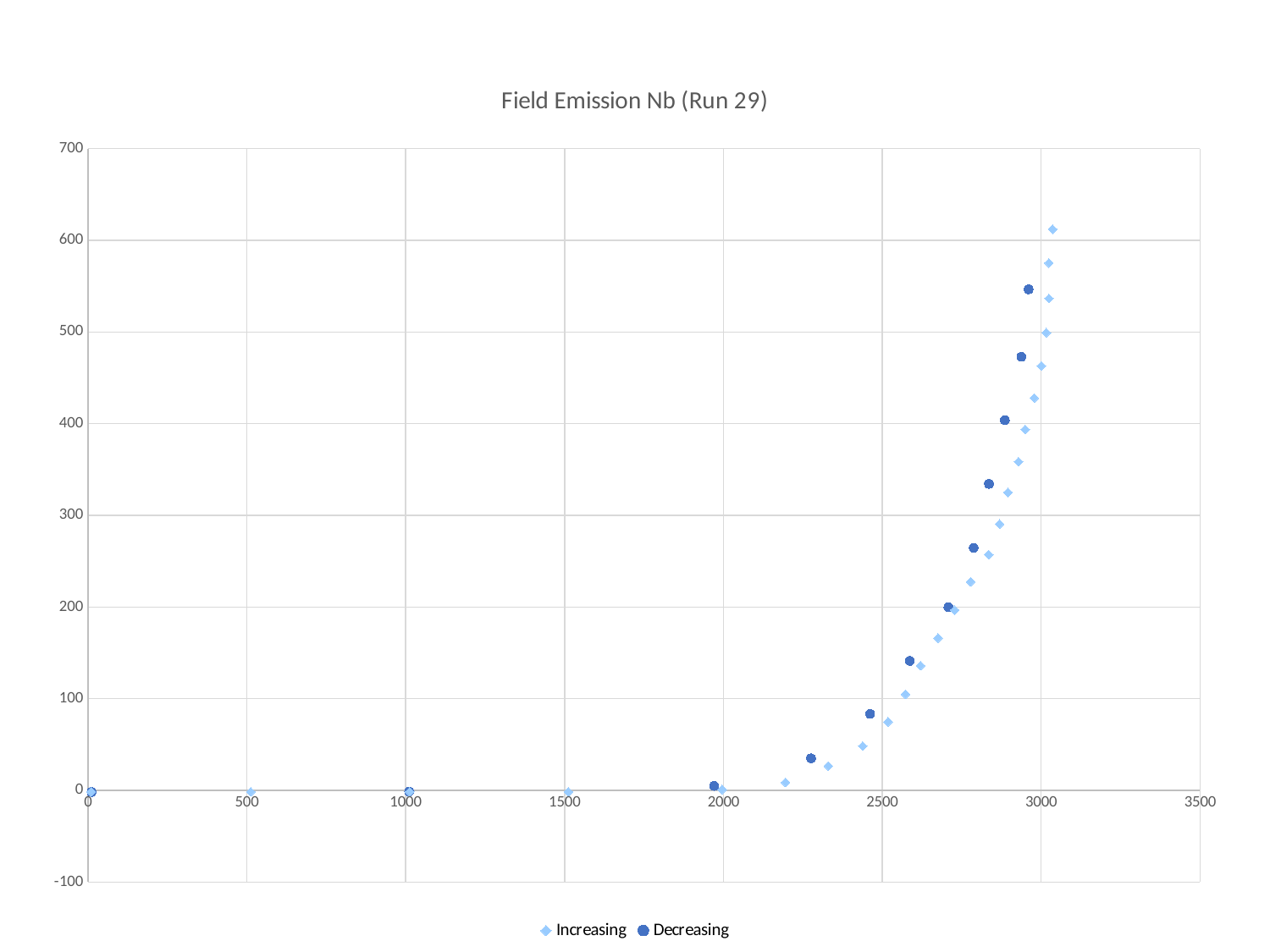
Which series reaches the highest plotted value on the chart? Increasing Are the plotted values for x values below 1500 greater or less than 100? less What are the names of the two series in the legend? Increasing and Decreasing Is the highest value of the Increasing series greater or less than the highest value of the Decreasing series? greater Is the highest value of the Decreasing series greater or less than 600? less What kind of chart is shown on the slide? scatter chart Is the value of the Decreasing series at roughly x = 2280 greater or less than 100? less What is the title of the chart? Field Emission Nb (Run 29) Do the plotted values rise or fall as the x value increases beyond 2000? rise How many series does the legend list? 2